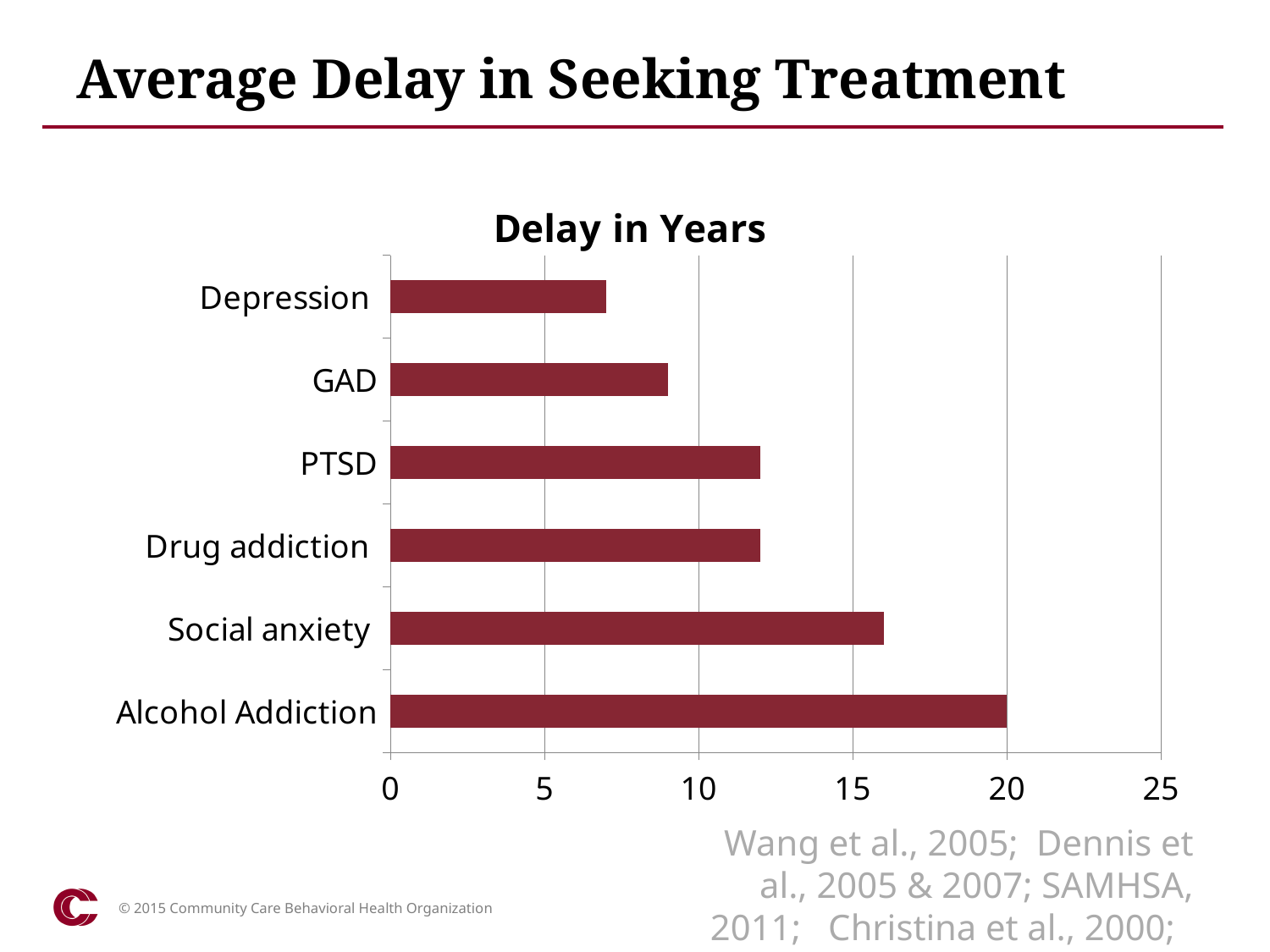
What kind of chart is shown on the slide? bar chart How many categories are plotted in the chart? 6 What is the title of the chart? Delay in Years Which has a longer delay, Social anxiety or GAD? Social anxiety Which has a longer delay, Alcohol Addiction or Drug addiction? Alcohol Addiction Is the value for GAD greater or less than 10? less Is the value for PTSD greater or less than 10? greater Which category has the shortest delay in years? Depression What is the delay in years for Alcohol Addiction? 20 Is the value for Depression greater or less than 10? less Which category has the longest delay in years? Alcohol Addiction